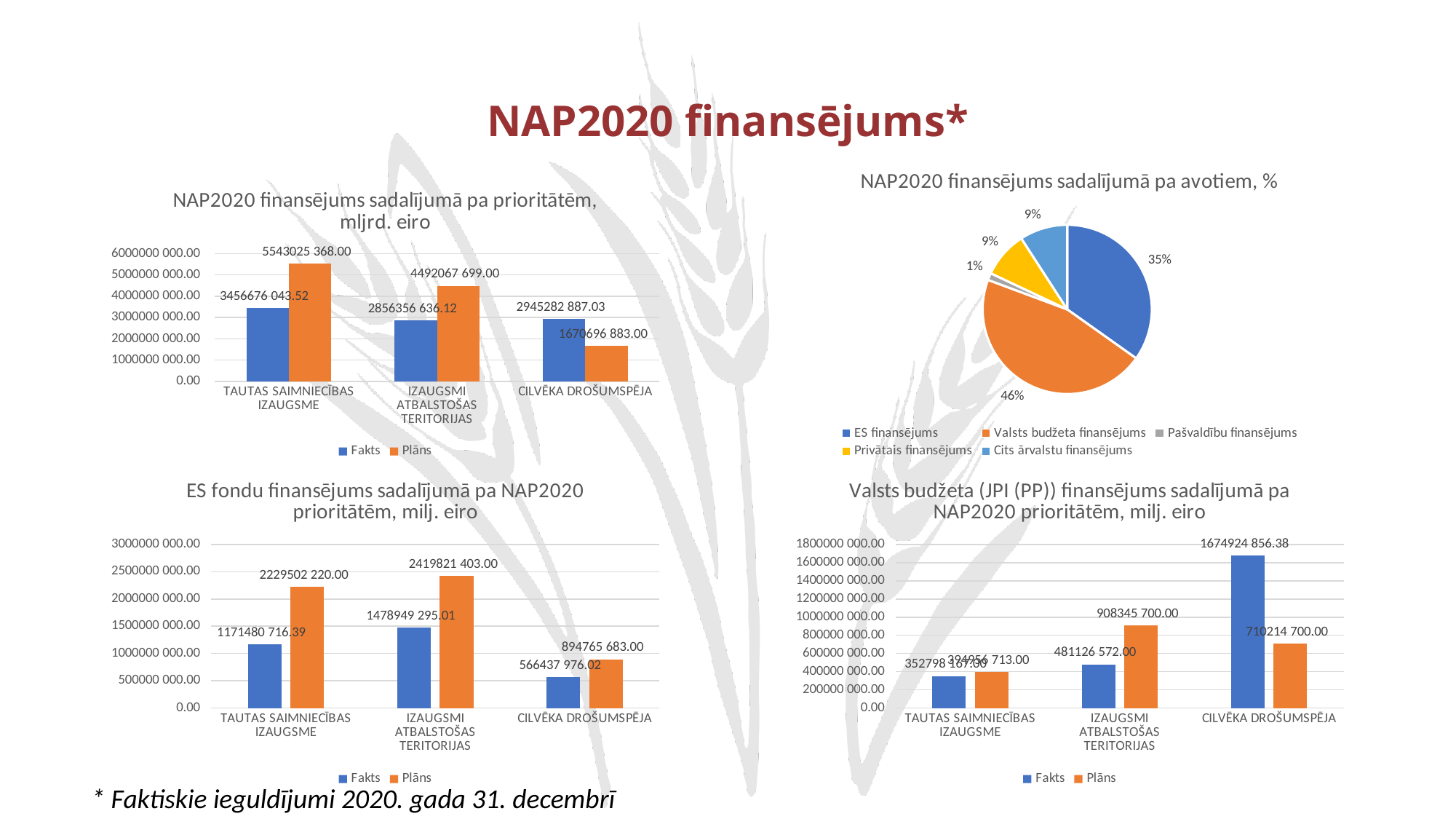
What type of chart is 'ES fondu finansējums sadalījumā pa NAP2020 prioritātēm, milj. eiro'? bar chart In the chart 'NAP2020 finansējums sadalījumā pa prioritātēm, mljrd. eiro', what is the Fakts value for CILVĒKA DROŠUMSPĒJA? 2945282 887.03 How many sources does the legend of the pie chart 'NAP2020 finansējums sadalījumā pa avotiem, %' list? 5 In the chart 'ES fondu finansējums sadalījumā pa NAP2020 prioritātēm, milj. eiro', which category has the highest Fakts value? IZAUGSMI ATBALSTOŠAS TERITORIJAS In the pie chart 'NAP2020 finansējums sadalījumā pa avotiem, %', which source has the smallest share? Pašvaldību finansējums In the chart 'NAP2020 finansējums sadalījumā pa prioritātēm, mljrd. eiro', what is the Plāns value for TAUTAS SAIMNIECĪBAS IZAUGSME? 5543025 368.00 In the chart 'NAP2020 finansējums sadalījumā pa prioritātēm, mljrd. eiro', which category has the lowest Plāns value? CILVĒKA DROŠUMSPĒJA In the chart 'Valsts budžeta (JPI (PP)) finansējums sadalījumā pa NAP2020 prioritātēm, milj. eiro', is the Plāns value for IZAUGSMI ATBALSTOŠAS TERITORIJAS greater or less than 1000000 000.00? less In the pie chart 'NAP2020 finansējums sadalījumā pa avotiem, %', what share does Valsts budžeta finansējums have? 46% In the chart 'NAP2020 finansējums sadalījumā pa prioritātēm, mljrd. eiro', is the Fakts value for CILVĒKA DROŠUMSPĒJA larger or smaller than its Plāns value? larger In the chart 'Valsts budžeta (JPI (PP)) finansējums sadalījumā pa NAP2020 prioritātēm, milj. eiro', what is the Fakts value for CILVĒKA DROŠUMSPĒJA? 1674924 856.38 In the chart 'ES fondu finansējums sadalījumā pa NAP2020 prioritātēm, milj. eiro', what is the Plāns value for IZAUGSMI ATBALSTOŠAS TERITORIJAS? 2419821 403.00